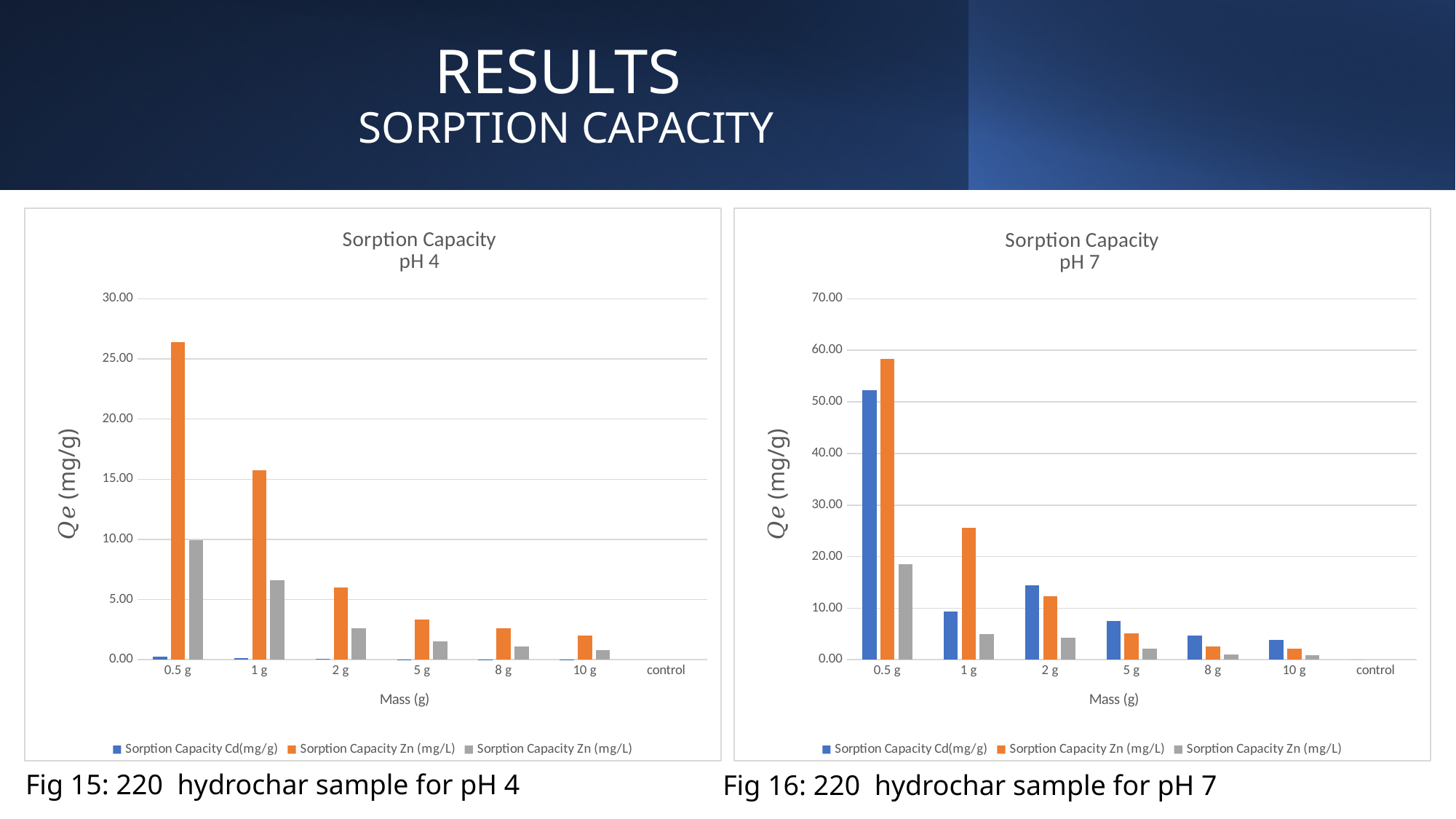
On the Sorption Capacity pH 4 chart, is the orange Sorption Capacity Zn (mg/L) value for 0.5 g greater or less than 25.00? greater On the Sorption Capacity pH 7 chart, how many series does the legend list? 3 On the Sorption Capacity pH 7 chart, do the orange Sorption Capacity Zn (mg/L) bars rise or fall as mass increases from 0.5 g to 10 g? fall On the Sorption Capacity pH 4 chart, is the orange Sorption Capacity Zn (mg/L) value for 2 g greater or less than 5.00? greater On the Sorption Capacity pH 7 chart, is the Sorption Capacity Cd(mg/g) value for 0.5 g greater or less than 50.00? greater On the Sorption Capacity pH 4 chart, how many mass categories are shown on the x axis? 7 On the Sorption Capacity pH 4 chart, what kind of chart is shown? bar chart On the Sorption Capacity pH 7 chart, at 0.5 g, which is larger: the Sorption Capacity Cd(mg/g) bar or the orange Sorption Capacity Zn (mg/L) bar? the orange Sorption Capacity Zn (mg/L) bar On the Sorption Capacity pH 4 chart, which mass has the highest orange Sorption Capacity Zn (mg/L) bar? 0.5 g What is the x-axis title of the Sorption Capacity pH 4 chart? Mass (g)